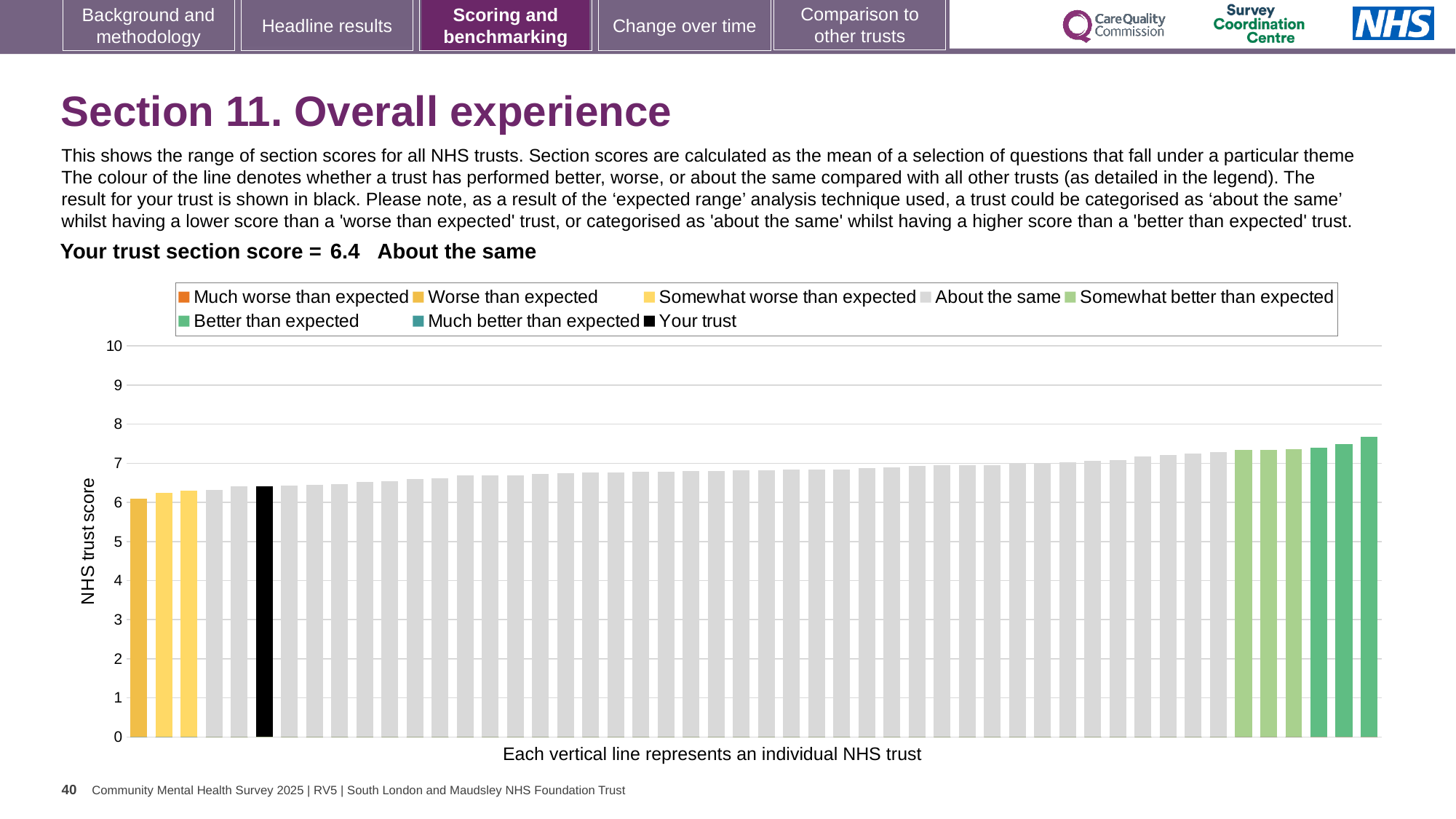
Do the bar values rise or fall from left to right along the x axis? Rise What kind of chart is shown on the slide? Bar chart What is the label on the vertical axis of the chart? NHS trust score According to the legend, what does a black bar represent? Your trust Is the value of the tallest bar greater or less than 8? less How is your trust's section score categorised compared with other trusts? About the same Is the value of the black bar (your trust) greater or less than 7? less Is the value of the shortest bar greater or less than 5? greater How many entries does the chart legend list? 8 Which is larger, the leftmost bar or the rightmost bar? The rightmost bar What is the section score for your trust shown on the slide? 6.4